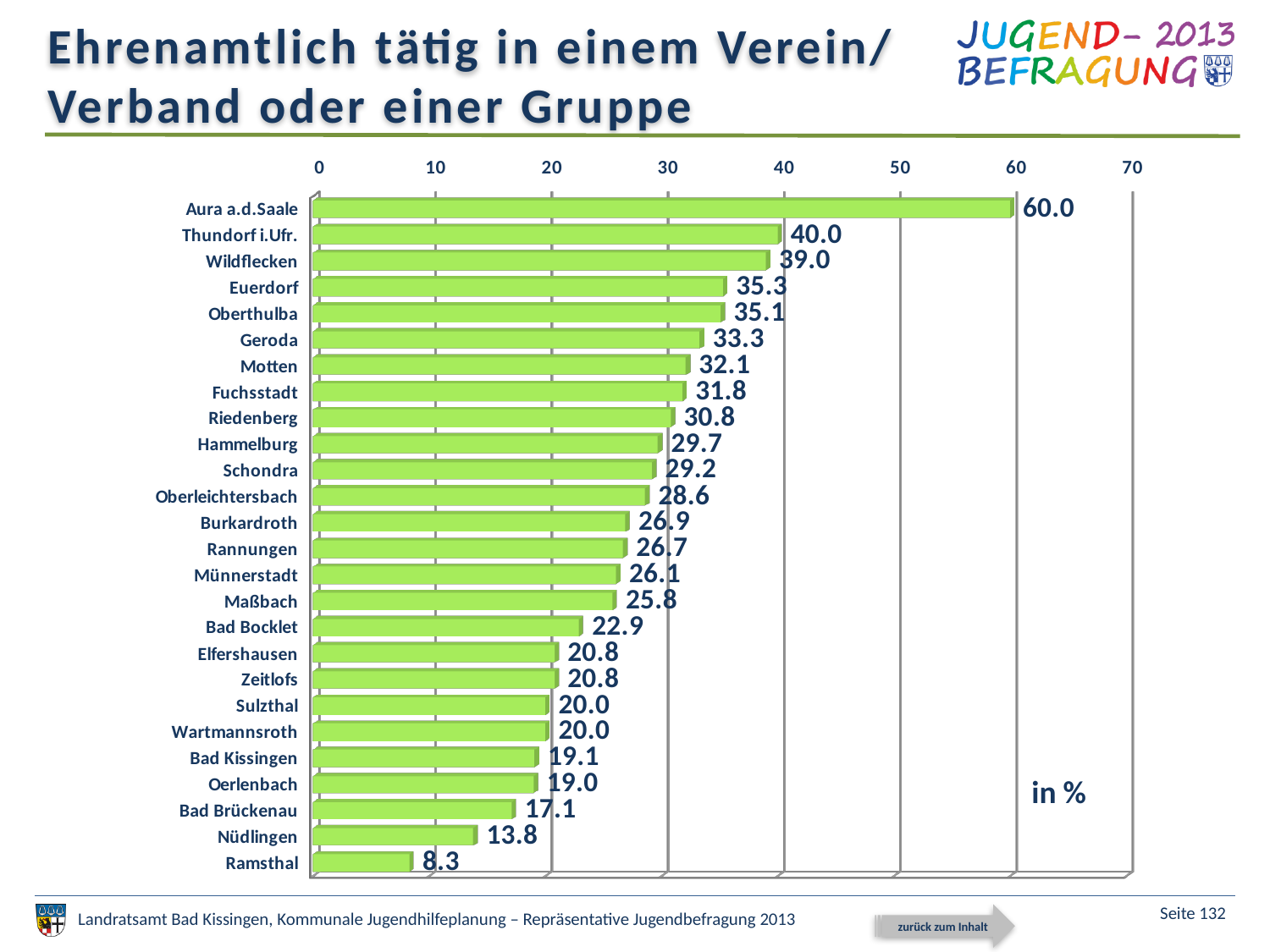
Which municipality has the highest value? Aura a.d.Saale What kind of chart is shown on the slide? bar chart What is the difference between the values for Aura a.d.Saale and Ramsthal? 51.7 Which municipality has the lowest value? Ramsthal What unit is indicated for the values in the chart? in % What is the difference between the values for Thundorf i.Ufr. and Wildflecken? 1.0 What is the value for Aura a.d.Saale? 60.0 Which is larger, the value for Geroda or the value for Motten? Geroda Is the value for Nüdlingen greater or less than 20? less What is the value for Hammelburg? 29.7 How many municipalities are shown in the chart? 26 What is the value for Bad Kissingen? 19.1